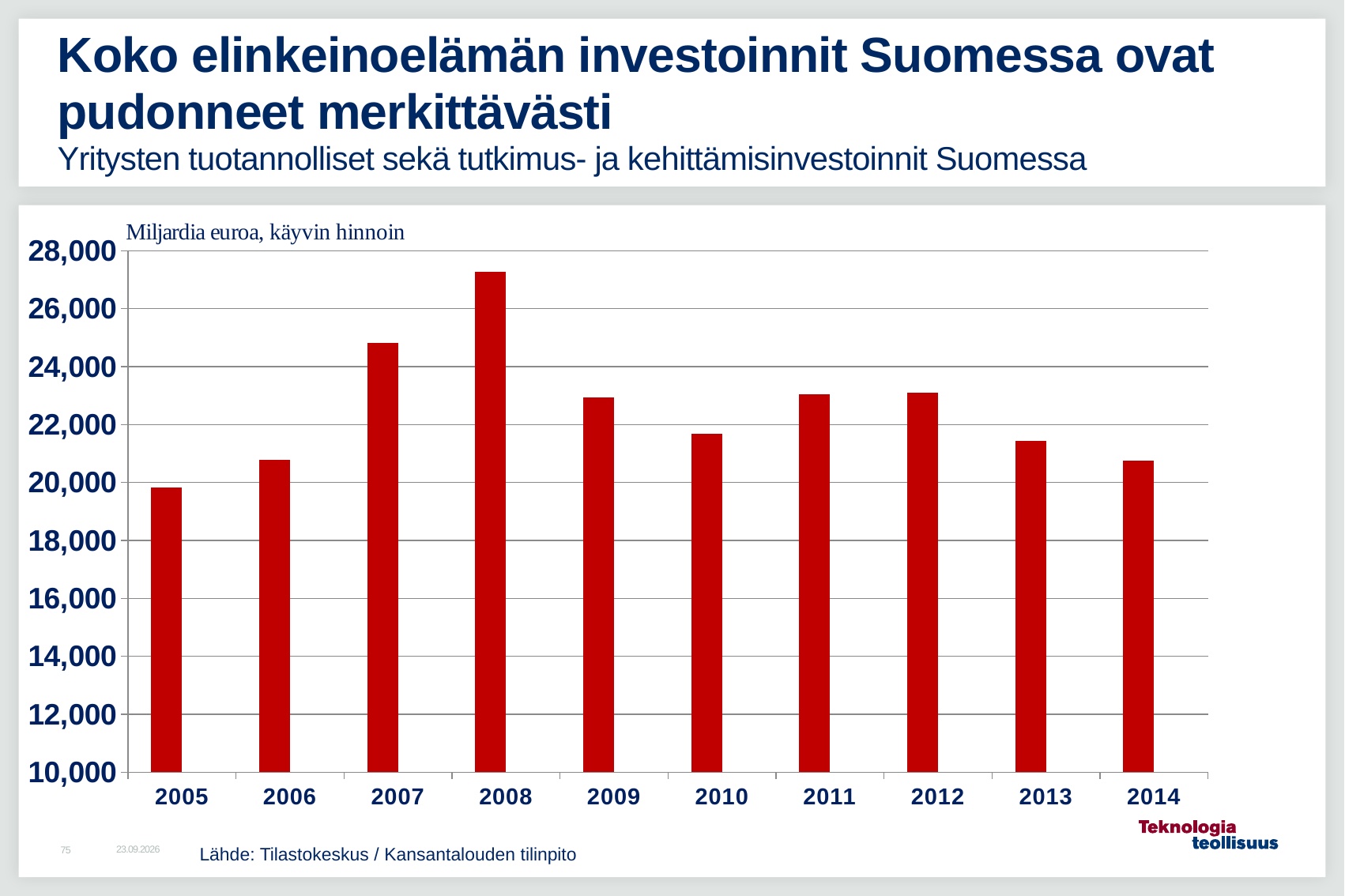
Is the value for 2010 greater or less than 22,000? less How many years are shown on the x axis of the chart? 10 Which is larger, the value for 2014 or the value for 2012? 2012 What kind of chart is shown on the slide? bar chart Do the values rise or fall from 2008 to 2010? fall Is the value for 2005 greater or less than 20,000? less Which is larger, the value for 2007 or the value for 2009? 2007 Is the value for 2013 greater or less than 22,000? less Which year has the highest value in the chart? 2008 Which year has the lowest value in the chart? 2005